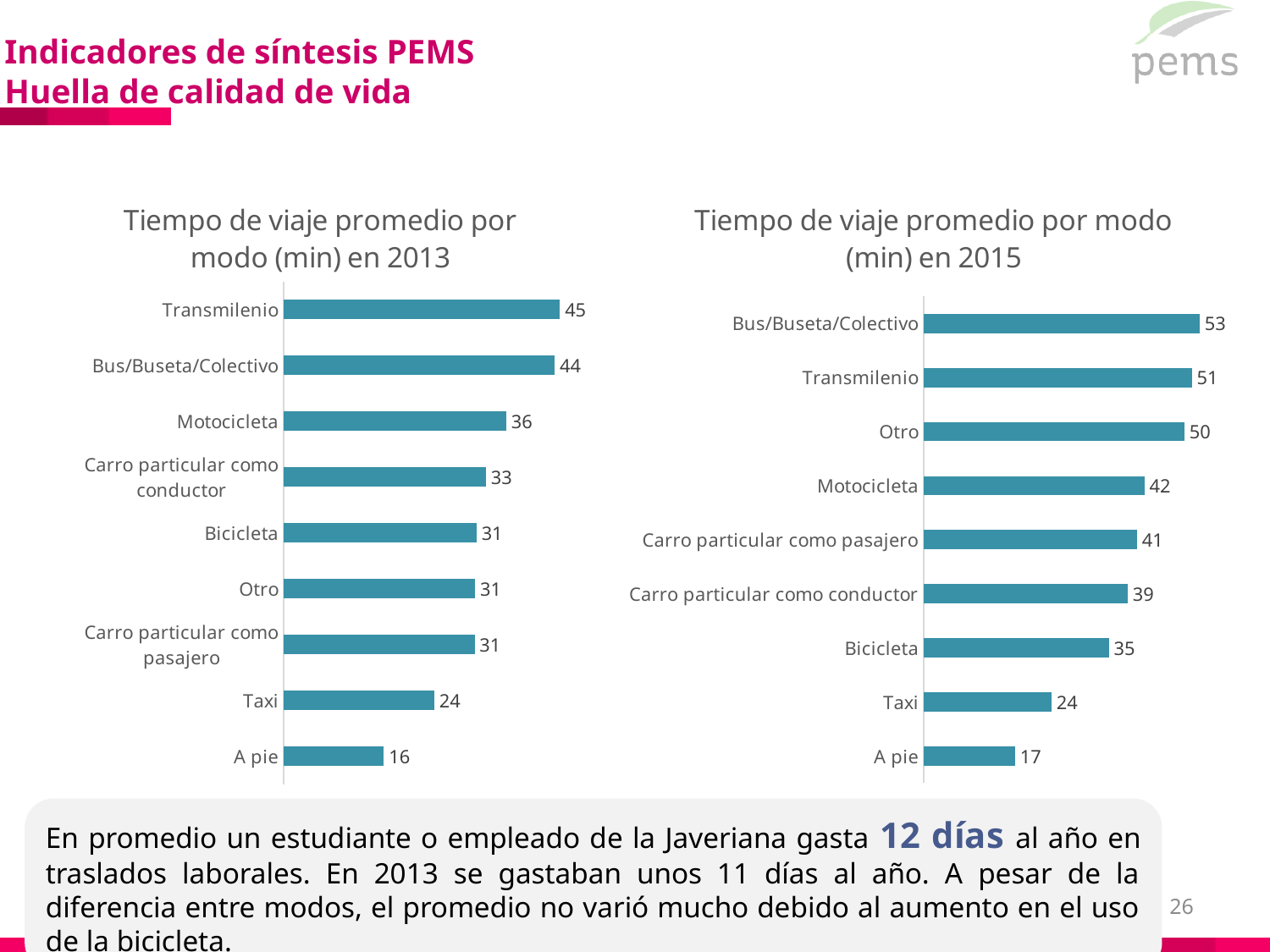
In the chart 'Tiempo de viaje promedio por modo (min) en 2015', what is the value for Bus/Buseta/Colectivo? 53 In the chart 'Tiempo de viaje promedio por modo (min) en 2013', which is larger, Motocicleta or Bicicleta? Motocicleta In the chart 'Tiempo de viaje promedio por modo (min) en 2015', which mode has the highest value? Bus/Buseta/Colectivo In the chart 'Tiempo de viaje promedio por modo (min) en 2013', what is the value for Transmilenio? 45 In the chart 'Tiempo de viaje promedio por modo (min) en 2013', which mode has the lowest value? A pie What kind of chart is 'Tiempo de viaje promedio por modo (min) en 2015'? Bar chart In the chart 'Tiempo de viaje promedio por modo (min) en 2015', which is larger, Taxi or Carro particular como pasajero? Carro particular como pasajero In the chart 'Tiempo de viaje promedio por modo (min) en 2015', what is the difference between Motocicleta and A pie? 25 In the chart 'Tiempo de viaje promedio por modo (min) en 2015', what is the value for Bicicleta? 35 In the chart 'Tiempo de viaje promedio por modo (min) en 2013', what is the value for Otro? 31 How many modes are shown in the chart 'Tiempo de viaje promedio por modo (min) en 2013'? 9 In the chart 'Tiempo de viaje promedio por modo (min) en 2013', what is the difference between Transmilenio and Taxi? 21